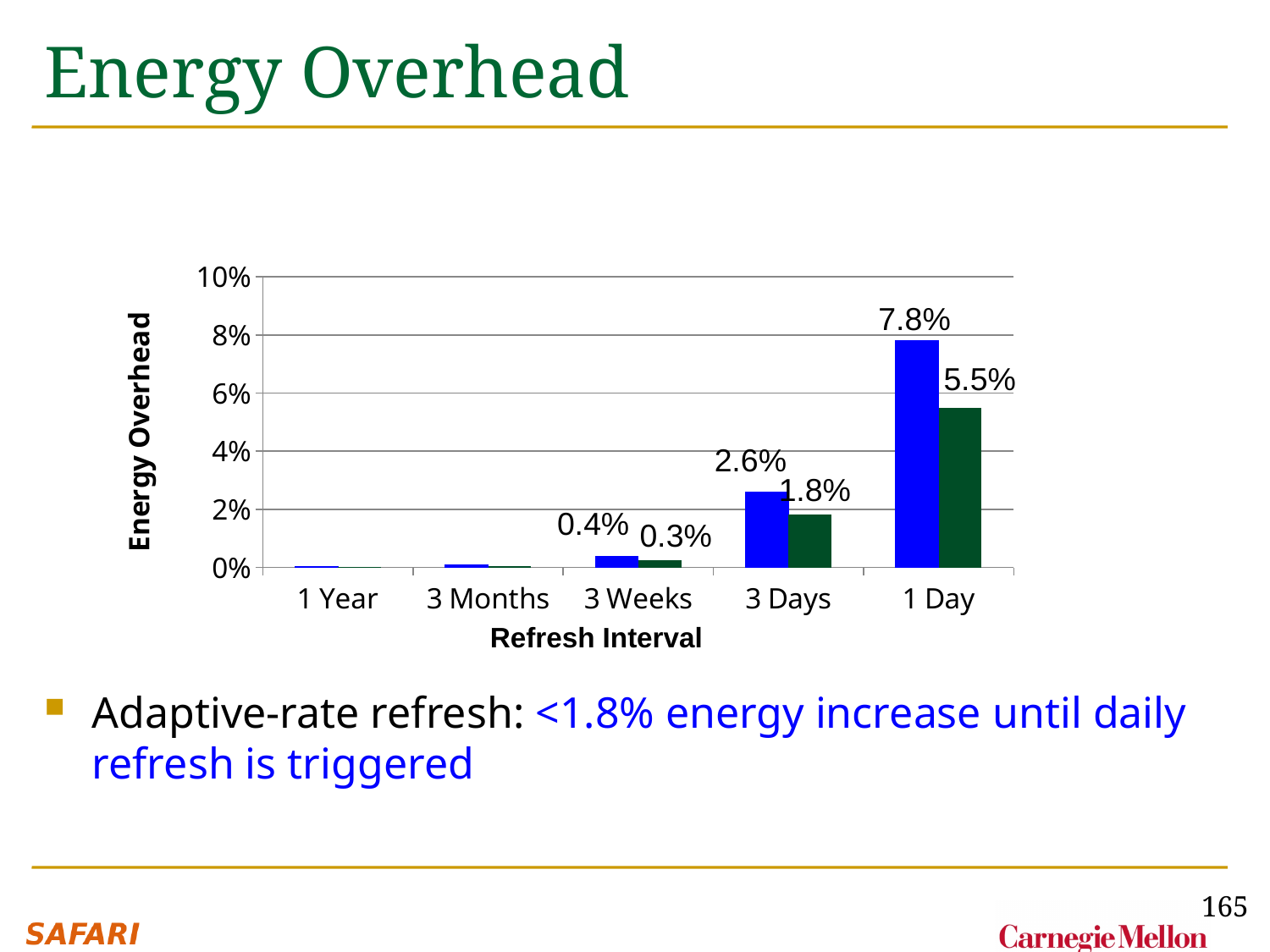
What is the value of the dark green bar for the 3 Weeks refresh interval? 0.3% Is the value of the blue bar for 1 Day greater or less than 6%? greater What is the label of the y axis? Energy Overhead What is the value of the dark green bar for the 1 Day refresh interval? 5.5% What type of chart is shown on the slide? bar chart What is the value of the blue bar for the 1 Day refresh interval? 7.8% What is the difference between the blue bar values for 1 Day and 3 Days? 5.2% Which refresh interval has the highest energy overhead for the blue bars? 1 Day What is the value of the blue bar for the 3 Days refresh interval? 2.6% What is the difference between the blue and dark green bars for the 1 Day refresh interval? 2.3% For the 3 Days refresh interval, which bar is larger, the blue or the dark green? blue How many refresh interval categories are shown on the x axis? 5